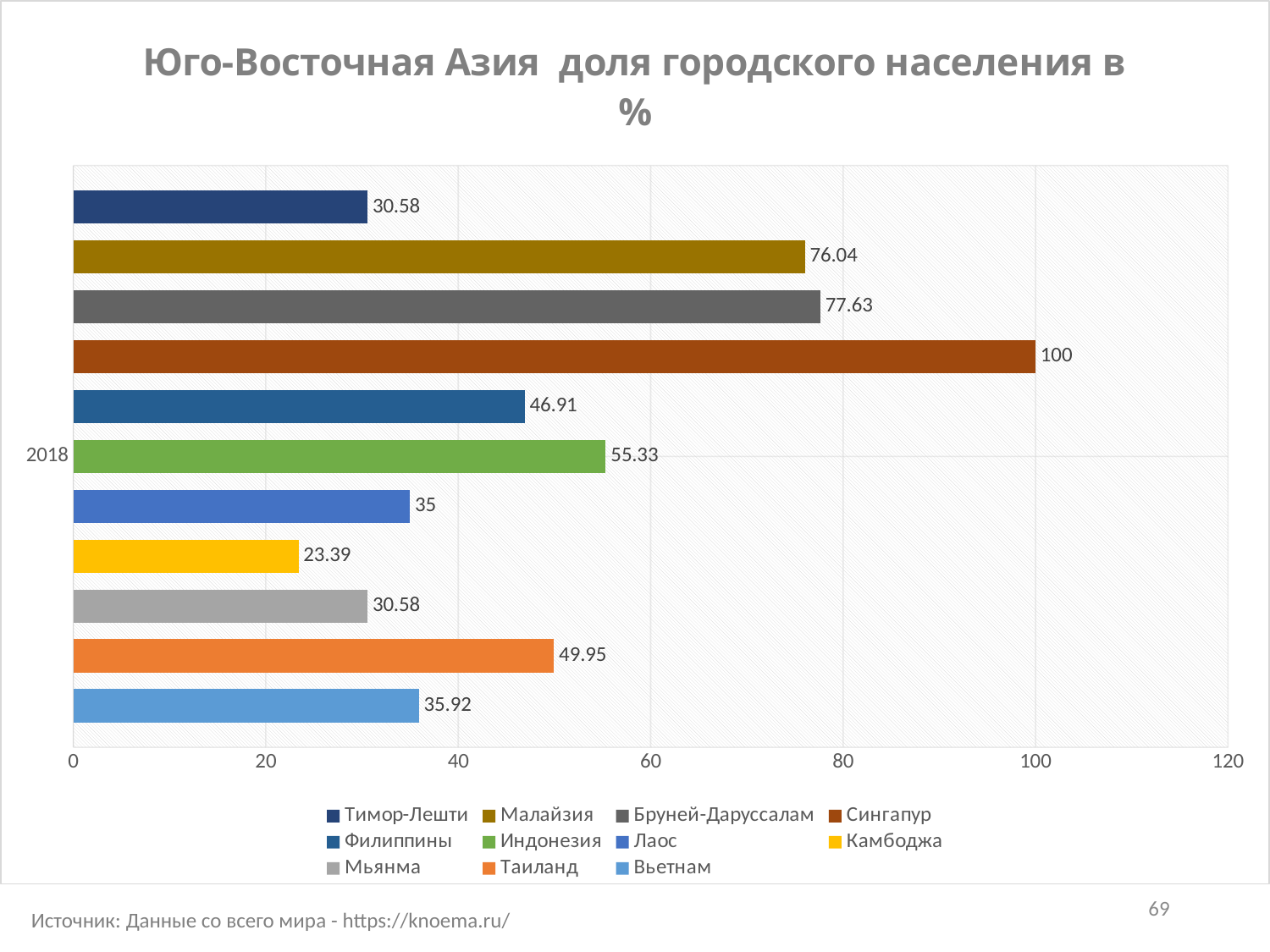
Which is larger, the value for Индонезия or the value for Филиппины? Индонезия What kind of chart is shown on the slide? bar chart How many series does the legend list? 11 Which country has the highest urban population share? Сингапур Which country has the lowest urban population share? Камбоджа What year is labelled on the vertical axis of the chart? 2018 What value is shown for Таиланд? 49.95 What value is shown for Камбоджа? 23.39 What is the urban population share for Сингапур? 100 What is the difference between the values for Сингапур and Малайзия? 23.96 What value is shown for Индонезия? 55.33 Is the value for Бруней-Даруссалам greater or less than 60? greater